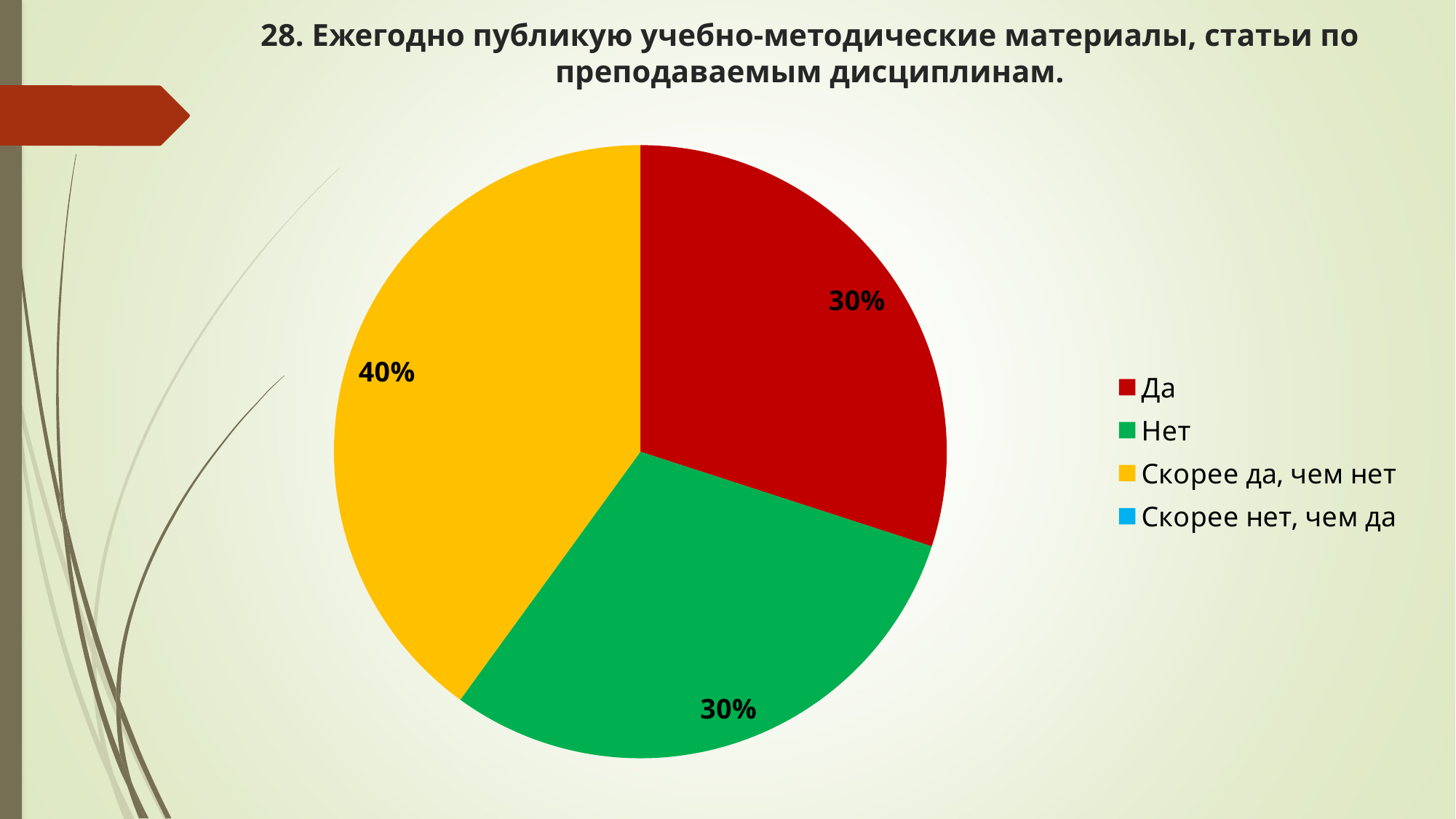
Which is larger: the share for "Скорее да, чем нет" or the share for "Нет"? Скорее да, чем нет What is the combined share of "Да" and "Нет"? 60% What colour is the slice for "Нет"? green What is the difference between the share for "Скорее да, чем нет" and the share for "Да"? 10% How many entries does the legend list? 4 What share of the pie does "Нет" have? 30% Which category has the largest slice of the pie? Скорее да, чем нет What share of the pie does "Да" have? 30% What share of the pie does "Скорее да, чем нет" have? 40% How many slices are visible in the pie? 3 Which legend entry has no visible slice in the pie? Скорее нет, чем да What kind of chart is shown on the slide? pie chart